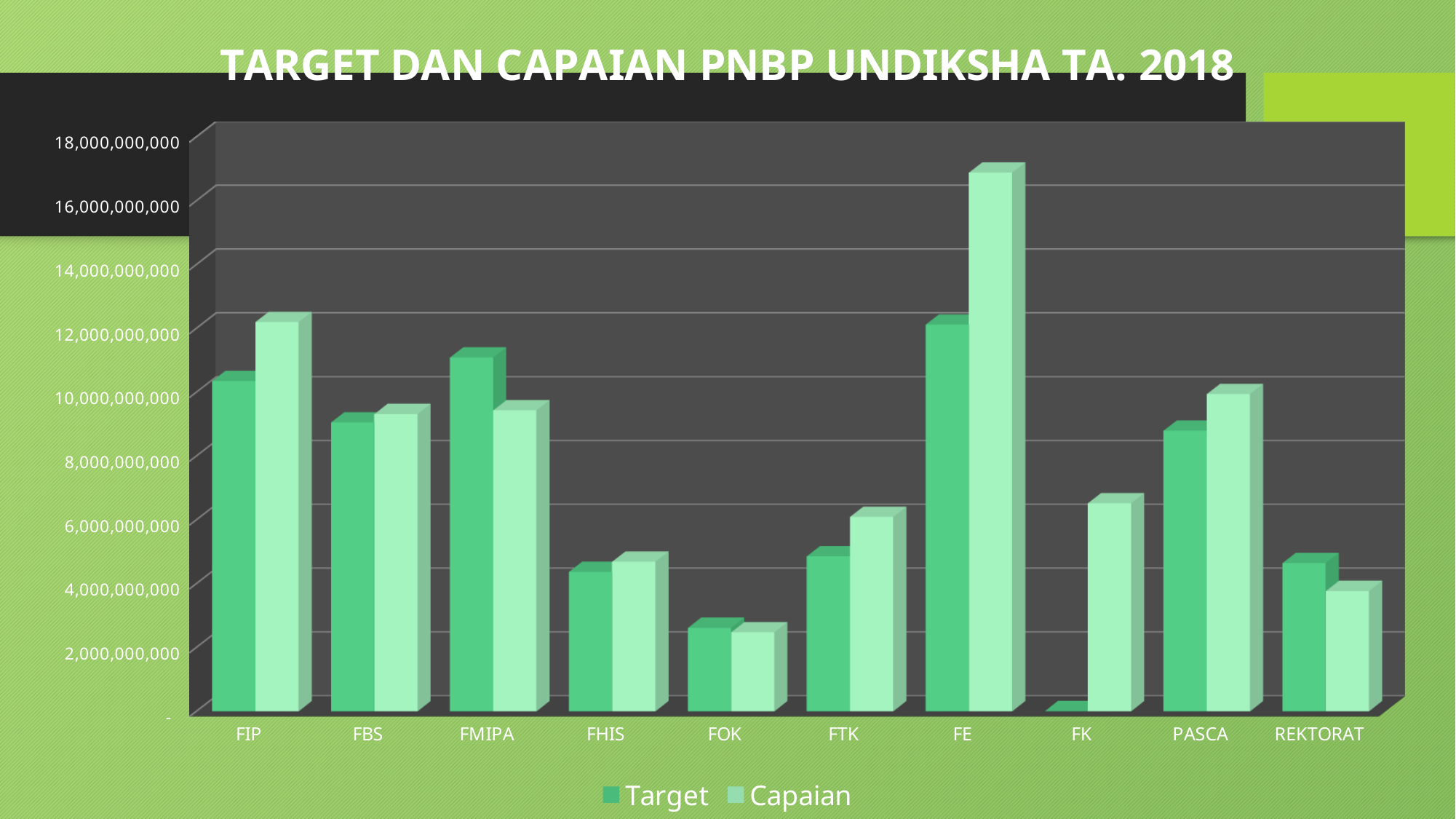
For FMIPA, which is larger: Target or Capaian? Target Is the Capaian value for FE greater or less than 16,000,000,000? greater How many categories are shown on the x axis of the chart? 10 Which category has the lowest Capaian value? FOK Is the Target value for FOK greater or less than 4,000,000,000? less Is the Target value for FMIPA greater or less than 10,000,000,000? greater Which category has the highest Capaian value? FE For FK, which is larger: Target or Capaian? Capaian What is the title of the chart? TARGET DAN CAPAIAN PNBP UNDIKSHA TA. 2018 Which category has the lowest Target value? FK How many series does the chart's legend list? 2 What kind of chart is shown on the slide? bar chart